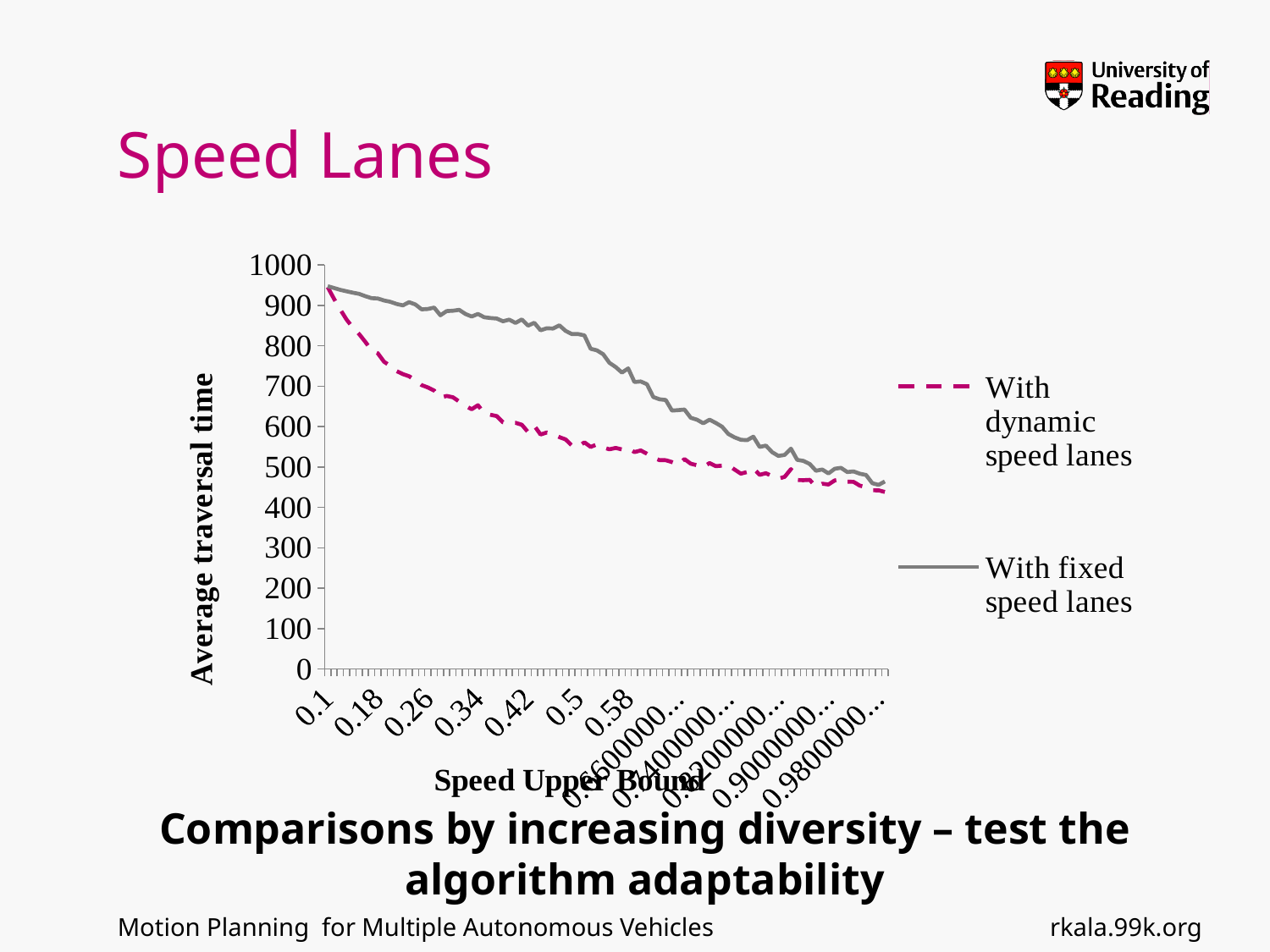
Is the value for 'With fixed speed lanes' at a speed upper bound of 0.26 greater or less than 800? greater How many series does the legend list? 2 Is the value for 'With dynamic speed lanes' at a speed upper bound of 0.26 greater or less than 800? less What kind of chart is shown on the slide? line chart What is the label of the vertical axis? Average traversal time Is the value for 'With dynamic speed lanes' at a speed upper bound of 0.5 greater or less than 700? less What are the two series named in the legend? With dynamic speed lanes; With fixed speed lanes At a speed upper bound of 0.5, which series has the higher average traversal time, 'With dynamic speed lanes' or 'With fixed speed lanes'? With fixed speed lanes Do the values for 'With fixed speed lanes' rise or fall as the speed upper bound increases? fall Do the values for 'With dynamic speed lanes' rise or fall as the speed upper bound increases? fall